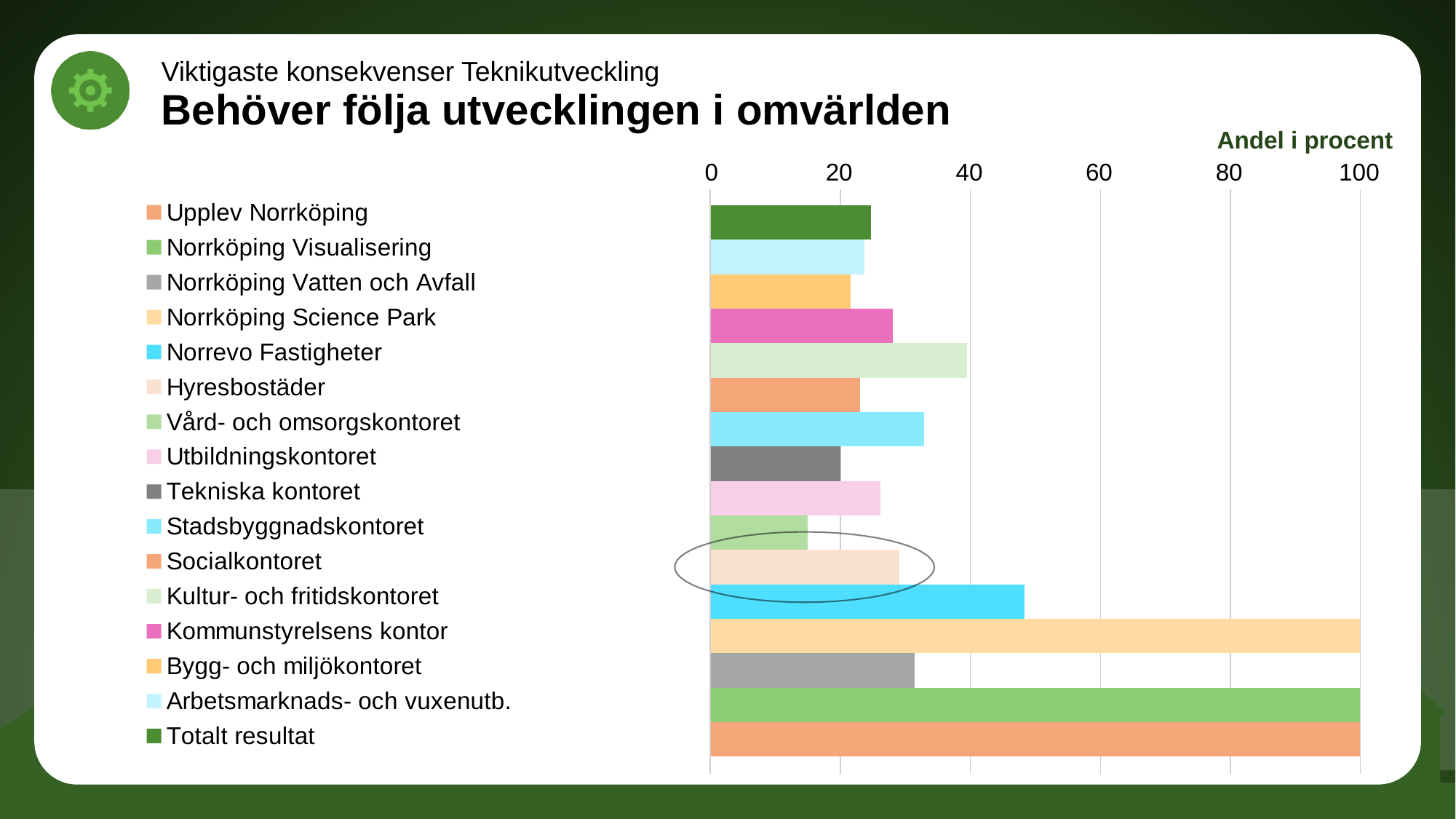
Is the value for Vård- och omsorgskontoret greater or less than 20? less What is the value for Upplev Norrköping? 100 What is the highest tick value shown on the horizontal axis? 100 What kind of chart is shown on the slide? bar chart Which category has the lowest value? Vård- och omsorgskontoret Which is larger, the value for Stadsbyggnadskontoret or the value for Kultur- och fritidskontoret? Kultur- och fritidskontoret What label is shown above the horizontal axis of the chart? Andel i procent Is the value for Hyresbostäder greater or less than 40? less Is the value for Totalt resultat greater or less than 20? greater How many categories does the chart's legend list? 16